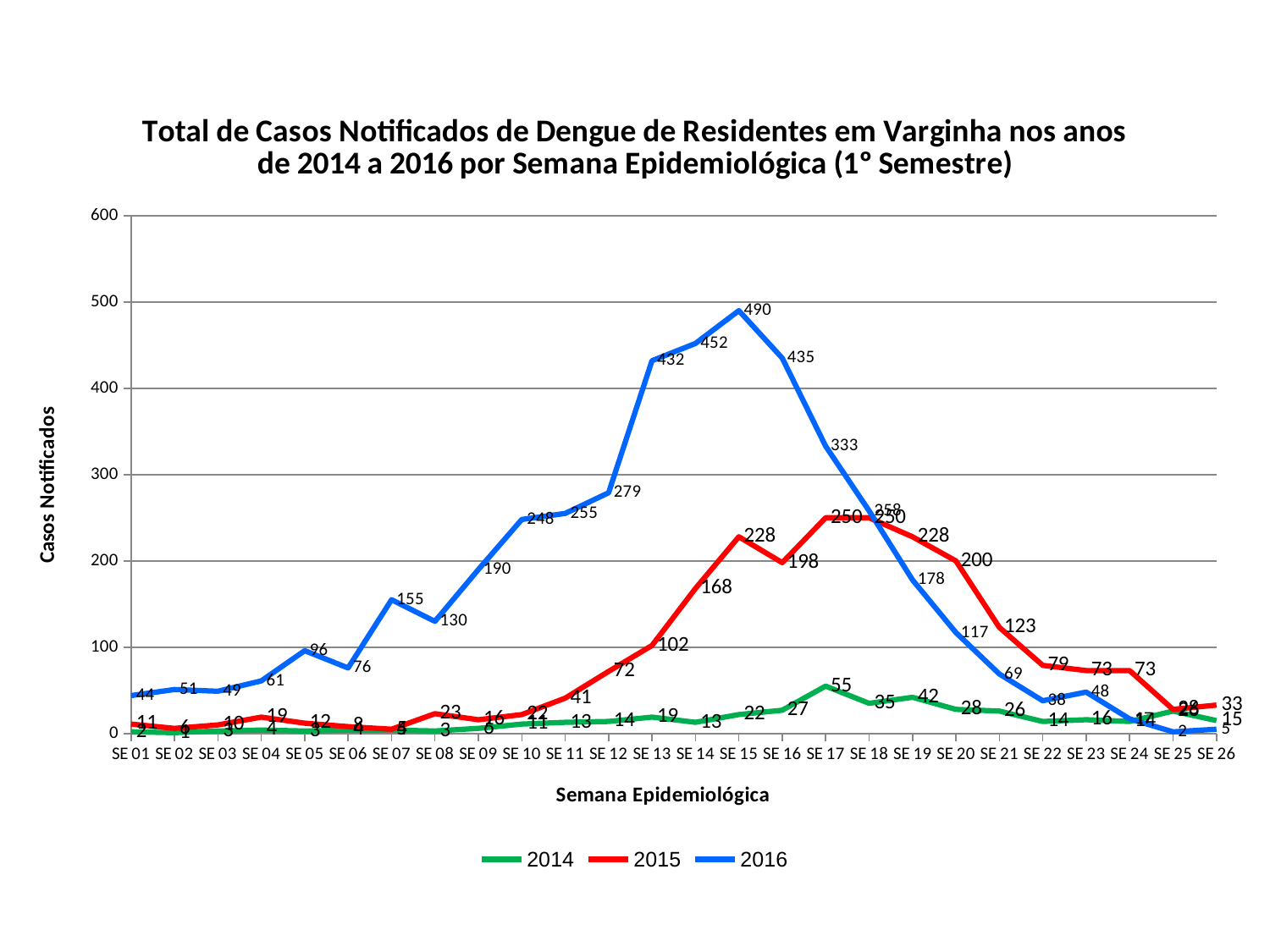
What is the difference between the 2016 values at SE 15 and SE 16? 55 What is the value for 2016 at SE 13? 432 In which week does the 2016 series reach its highest value? SE 15 How many series does the legend list? 3 In which week does the 2014 series reach its highest value? SE 17 How many epidemiological weeks (categories) are plotted on the x axis? 26 What is the value for 2015 at SE 14? 168 What kind of chart is shown on the slide? line chart What is the value for 2016 at SE 15? 490 What is the value for 2014 at SE 19? 42 Does the 2016 series rise or fall from SE 15 to SE 26? fall At SE 17, which series has the larger value, 2015 or 2016? 2016